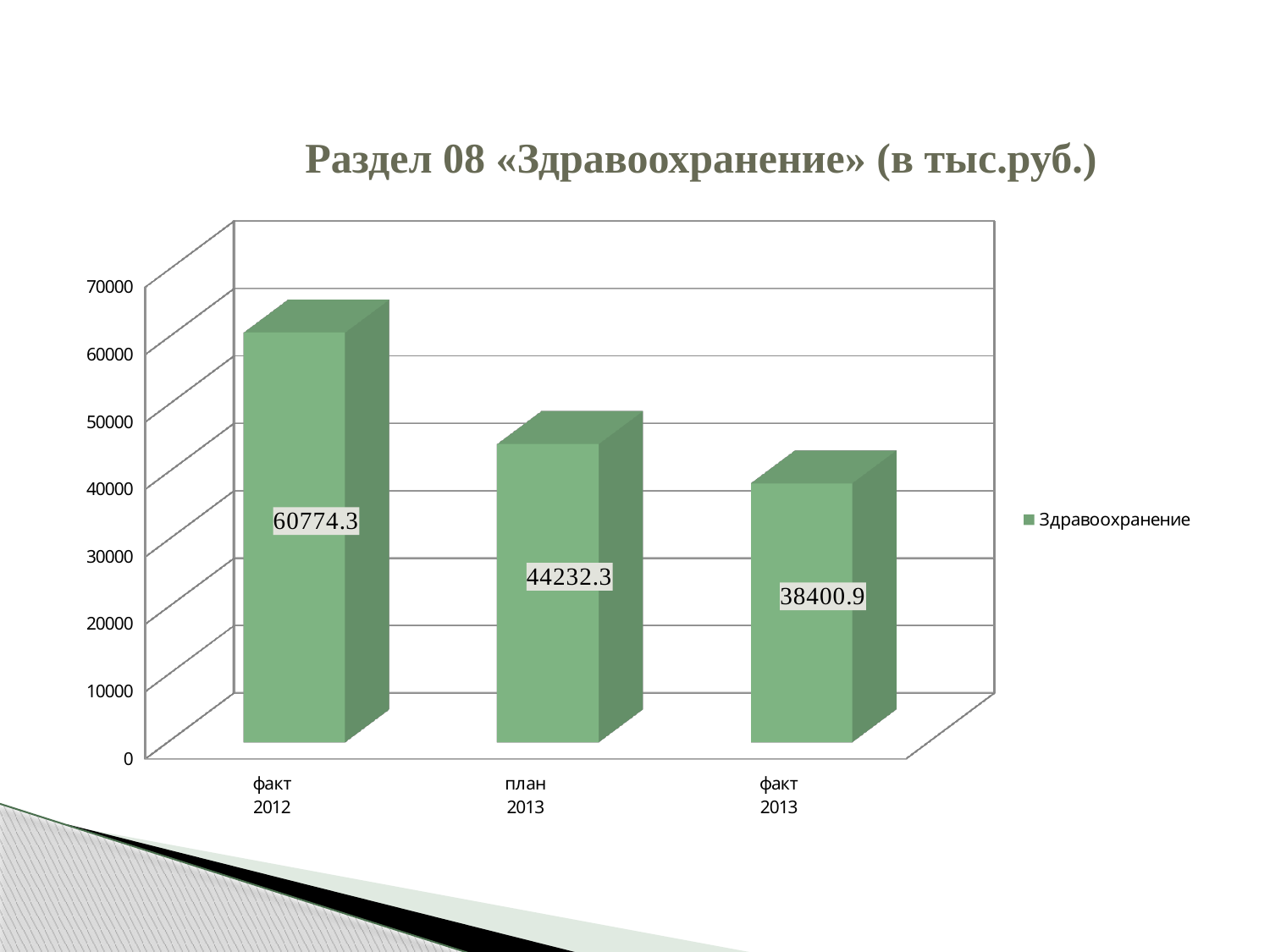
What is the value for факт 2013? 38400.9 What kind of chart is shown on the slide? bar chart Which category has the lowest value? факт 2013 What is the difference between the values for план 2013 and факт 2013? 5831.4 Which category has the highest value? факт 2012 How many categories are shown on the x axis? 3 Which is larger, the value for факт 2012 or the value for план 2013? факт 2012 What is the difference between the values for факт 2012 and факт 2013? 22373.4 What is the value for факт 2012? 60774.3 What is the value for план 2013? 44232.3 How many series does the legend list? 1 Do the values rise or fall from left to right along the x axis? fall